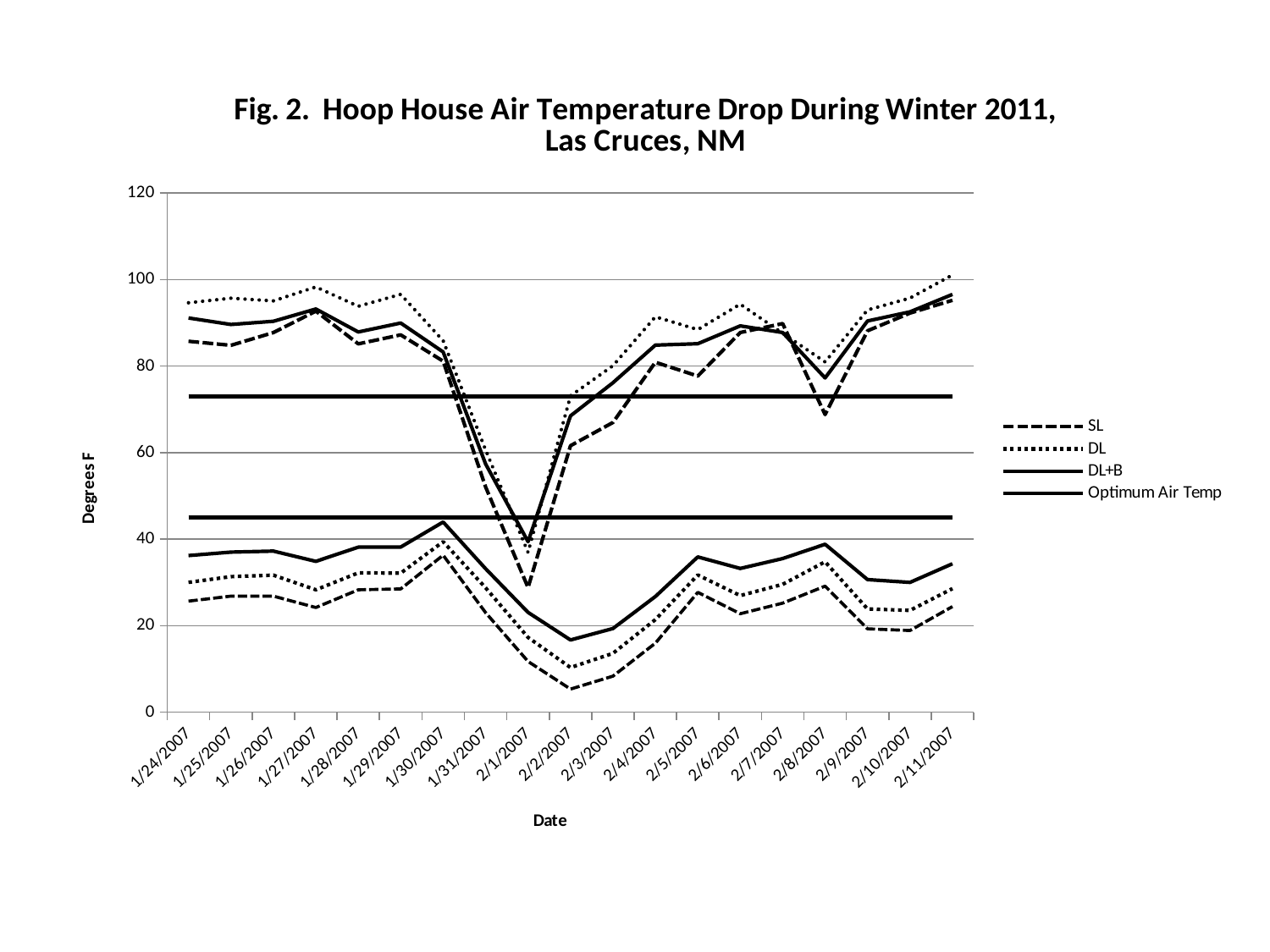
Is the value of the upper DL+B line on 2/1/2007 greater or less than 60? less Is the value of the upper DL line on 1/27/2007 greater or less than 100? less Do the upper lines rise or fall between 2/8/2007 and 2/11/2007? rise What is the label of the y axis? Degrees F How many series does the legend list? 4 Do the lower lines rise or fall between 1/30/2007 and 2/2/2007? fall What kind of chart is shown on the slide? line chart Is the value of the upper SL line on 1/24/2007 greater or less than 80? greater On which date does the lower SL line reach its lowest value? 2/2/2007 How many dates are shown along the x axis? 19 What is the title of the chart? Fig. 2. Hoop House Air Temperature Drop During Winter 2011, Las Cruces, NM